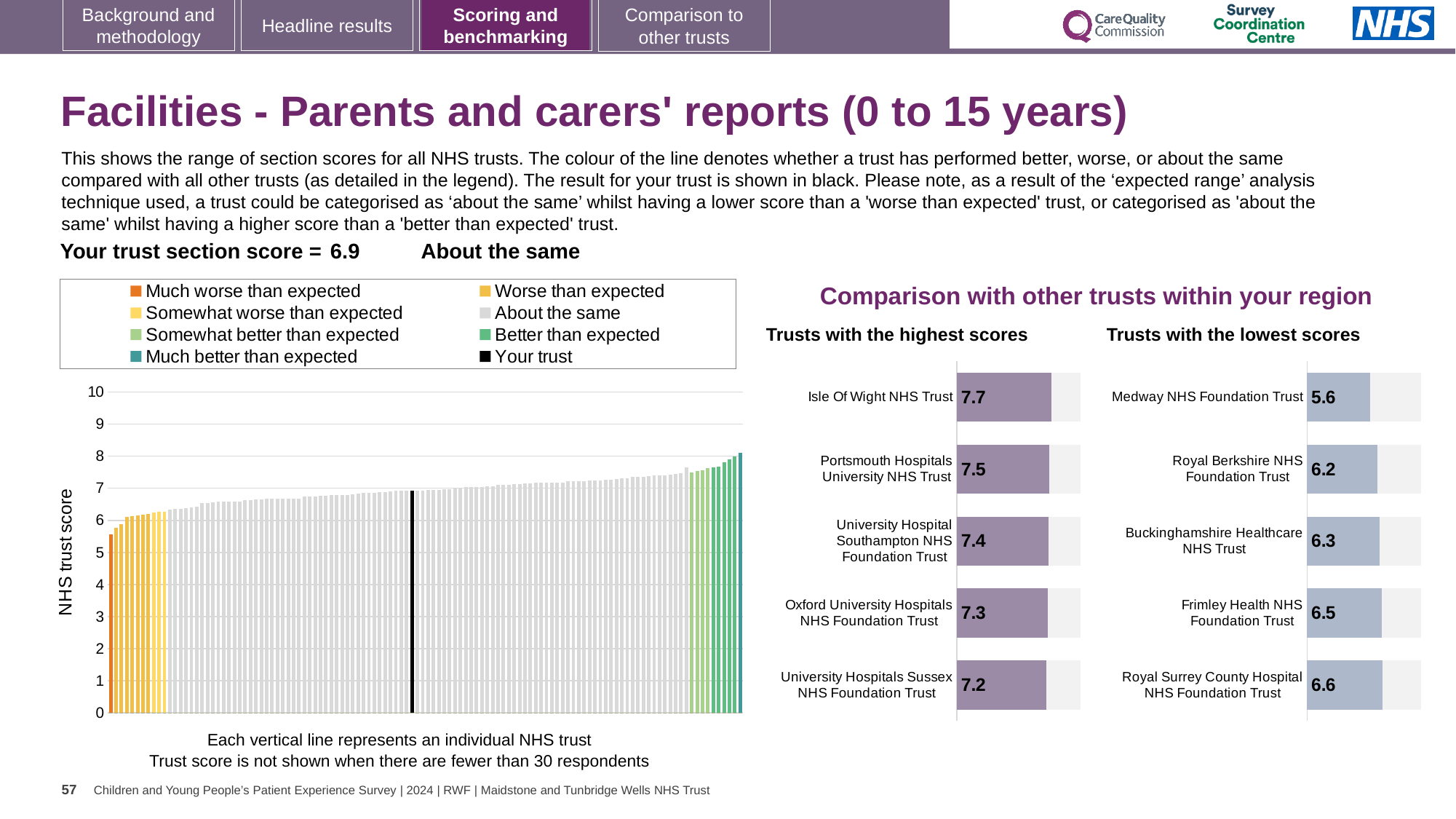
How many entries does the legend of the main chart on the left list? 8 In the 'Trusts with the highest scores' chart, what is the difference between the scores of Isle Of Wight NHS Trust and Portsmouth Hospitals University NHS Trust? 0.2 In the 'Trusts with the highest scores' chart, what is the score for Isle Of Wight NHS Trust? 7.7 In the main chart on the left, do the trust scores rise or fall from left to right? rise In the 'Trusts with the lowest scores' chart, which trust has the highest score? Royal Surrey County Hospital NHS Foundation Trust In the main chart on the left, what is the section score for your trust (the black line)? 6.9 In the 'Trusts with the lowest scores' chart, what is the score for Medway NHS Foundation Trust? 5.6 How many trusts are shown in the 'Trusts with the lowest scores' chart? 5 In the 'Trusts with the highest scores' chart, what is the score for Oxford University Hospitals NHS Foundation Trust? 7.3 What kind of chart is the 'Trusts with the highest scores' chart? bar chart In the 'Trusts with the lowest scores' chart, which has the larger score: Royal Berkshire NHS Foundation Trust or Frimley Health NHS Foundation Trust? Frimley Health NHS Foundation Trust In the 'Trusts with the highest scores' chart, which trust has the lowest score? University Hospitals Sussex NHS Foundation Trust